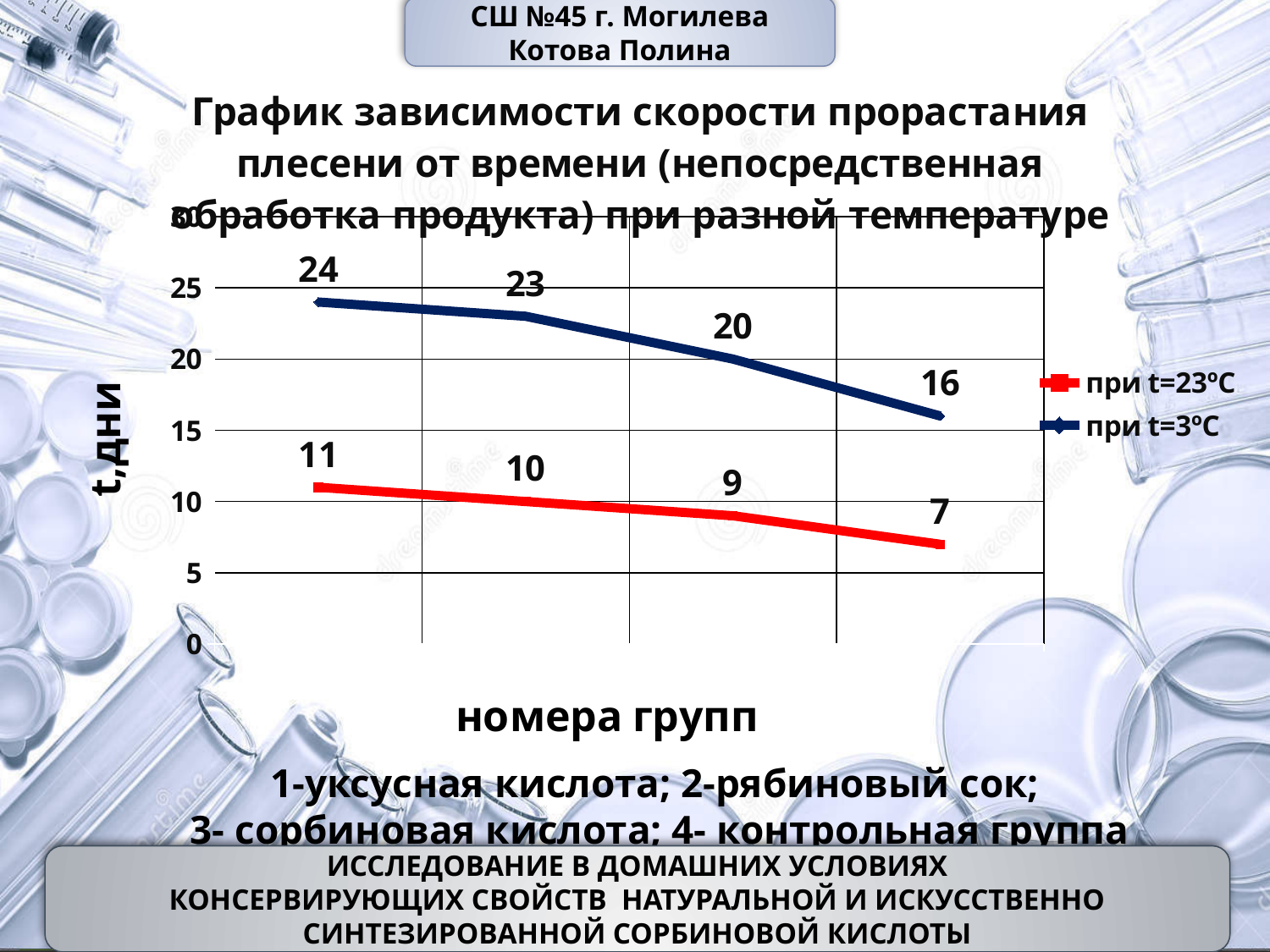
What kind of chart is shown on the slide? line chart How many series does the legend list? 2 What is the difference between the first points of the 'при t=3ºC' and 'при t=23ºC' series? 13 Do the values of the 'при t=23ºC' series rise or fall along the x axis? fall What is the difference between the first and last points of the 'при t=3ºC' series? 8 What colour is the line for the 'при t=23ºC' series? red What is the value of the third point of the 'при t=3ºC' series? 20 What is the value of the second point of the 'при t=23ºC' series? 10 How many data points does each series have? 4 Which series has the higher values, 'при t=23ºC' or 'при t=3ºC'? при t=3ºC What is the value of the first point of the 'при t=3ºC' series? 24 What is the value of the last (fourth) point of the 'при t=23ºC' series? 7